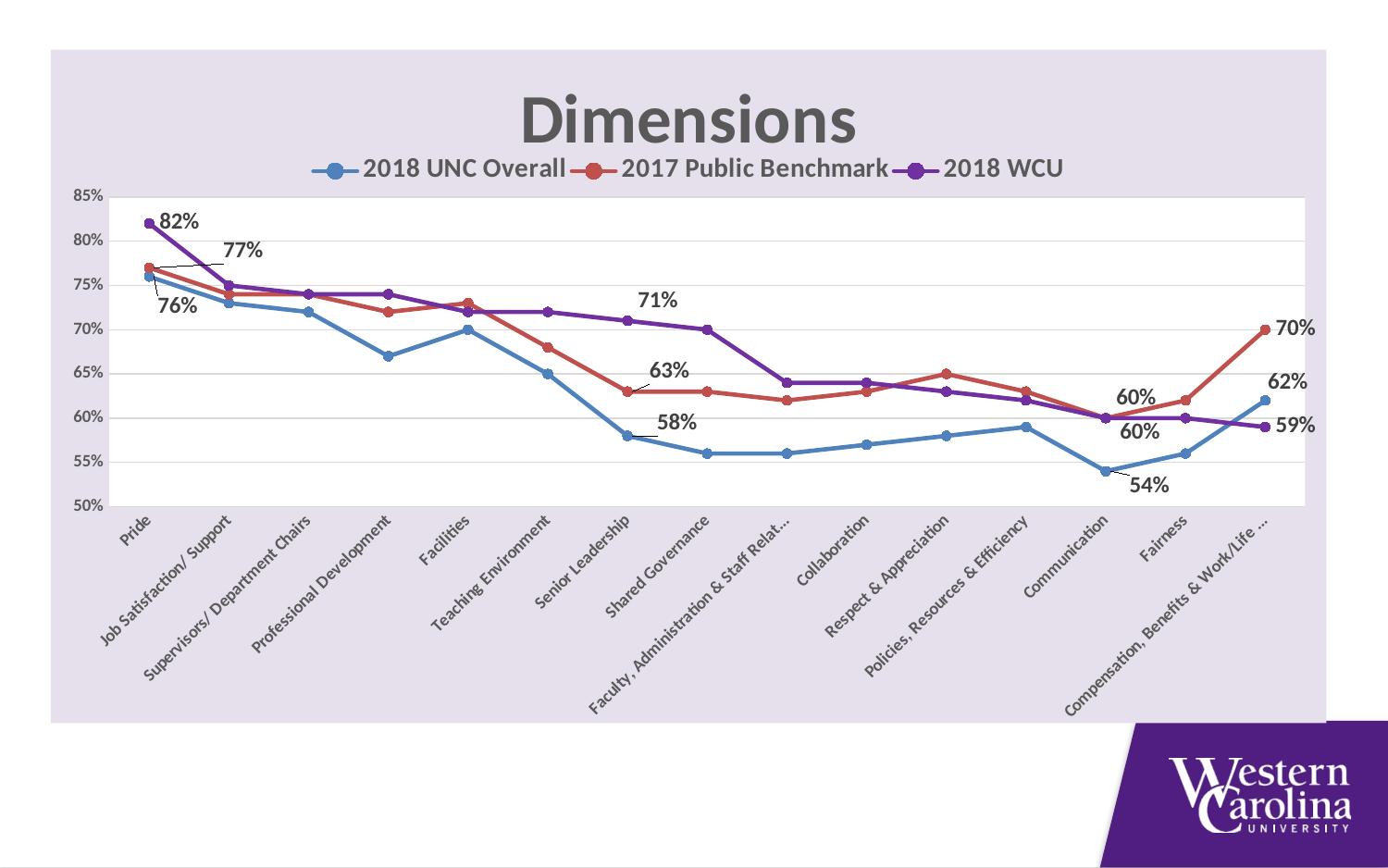
How many categories are plotted along the x axis? 15 For Compensation, Benefits & Work/Life, which is larger: the 2017 Public Benchmark value or the 2018 UNC Overall value? 2017 Public Benchmark What is the difference between the 2018 WCU and 2018 UNC Overall values for Pride? 6 percentage points What type of chart is shown on the slide? Line chart Is the 2018 UNC Overall value for Professional Development greater or less than 70%? less How many series does the legend list? 3 What is the 2018 WCU value for Senior Leadership? 71% What is the 2018 WCU value for Pride? 82% What is the 2017 Public Benchmark value for Pride? 77% What is the 2018 UNC Overall value for Communication? 54% Which category has the lowest 2018 UNC Overall value? Communication Which category has the highest 2018 WCU value? Pride